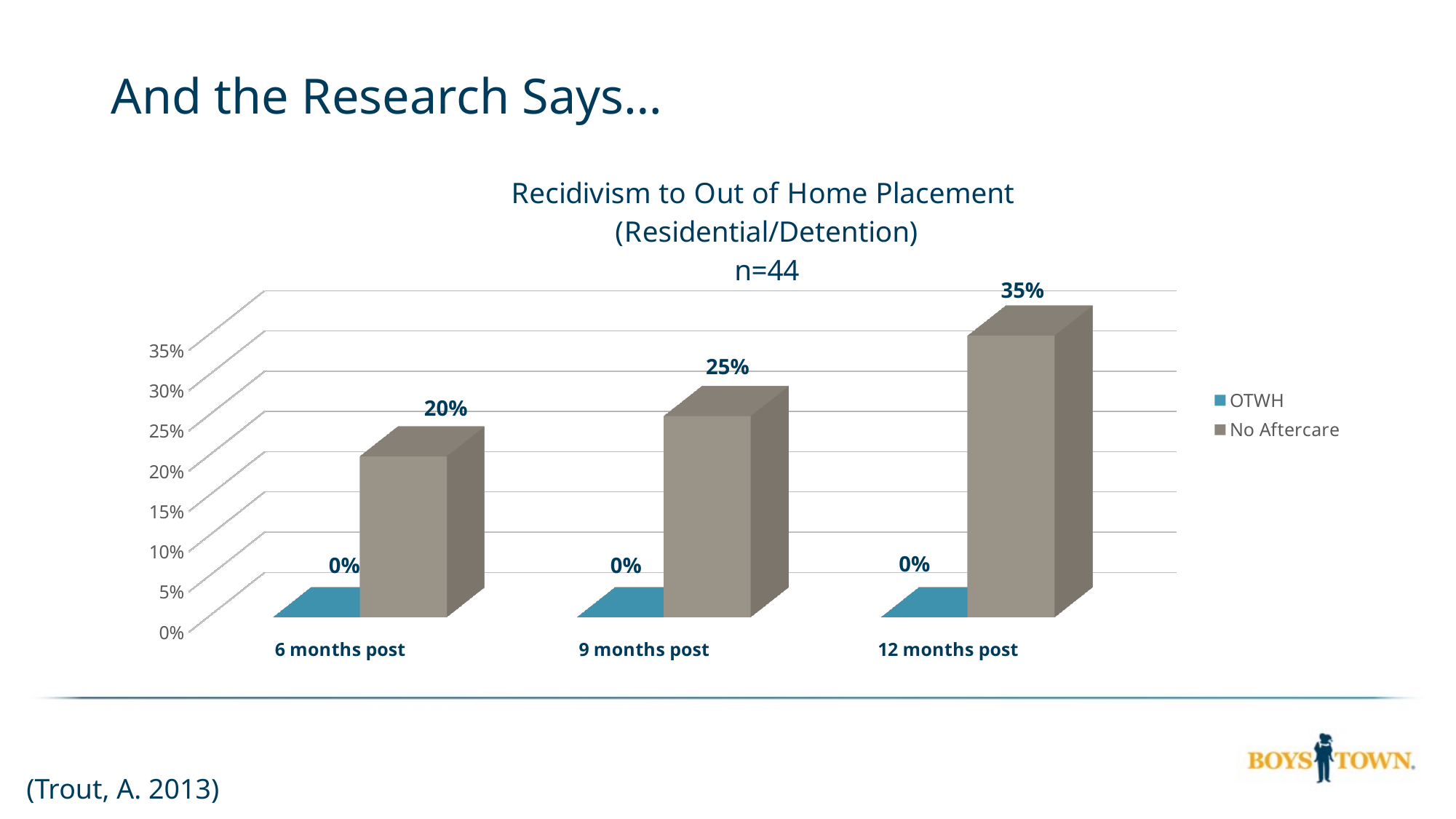
What is the difference between the No Aftercare values at 12 months post and 6 months post? 15% Which is larger at 9 months post: the OTWH value or the No Aftercare value? No Aftercare What is the OTWH value at 12 months post? 0% Do the No Aftercare values rise or fall from 6 months post to 12 months post? Rise How many series does the legend list? 2 At which time point is the No Aftercare value highest? 12 months post What is the No Aftercare value at 12 months post? 35% What is the No Aftercare value at 9 months post? 25% What kind of chart is shown? Bar chart What is the No Aftercare value at 6 months post? 20% At which time point is the No Aftercare value lowest? 6 months post How many time points are shown on the x axis? 3